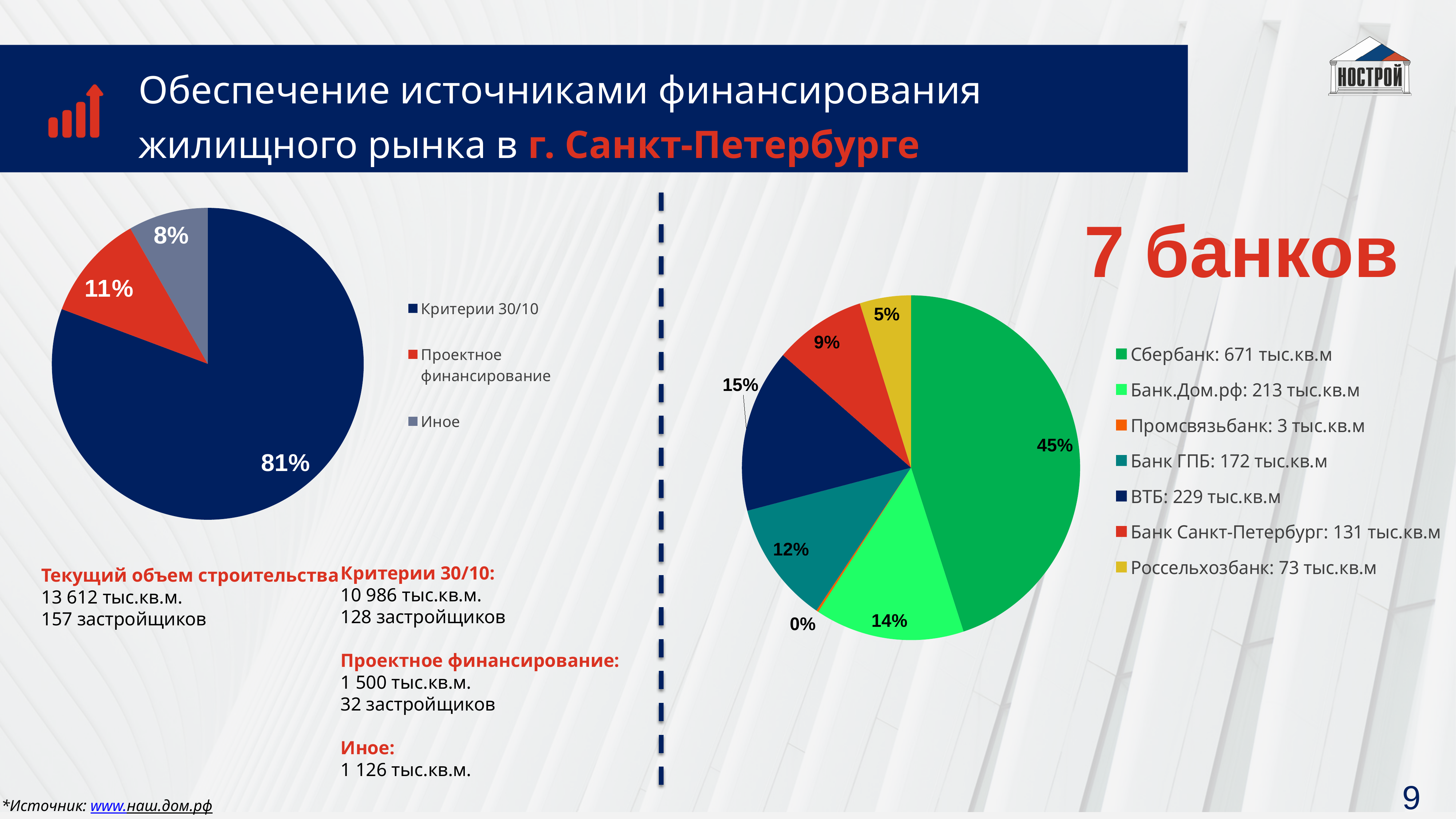
In the right pie chart, which bank has the largest slice? Сбербанк In the right pie chart, what value does the legend give for ВТБ? 229 тыс.кв.м In the left pie chart, which category has the smallest slice? Иное In the left pie chart, what share is labelled for Проектное финансирование? 11% In the right pie chart, what is the difference in percentage points between the Сбербанк slice and the ВТБ slice? 30 percentage points What kind of chart is the chart on the left of the slide? Pie chart In the right pie chart, which is larger: the slice for Банк ГПБ or the slice for Россельхозбанк? Банк ГПБ How many entries does the legend of the left pie chart list? 3 In the right pie chart, which bank has the smallest slice? Промсвязьбанк In the right pie chart, what share is labelled for Сбербанк? 45% How many banks are shown in the right pie chart? 7 In the left pie chart, what share is labelled for Критерии 30/10? 81%